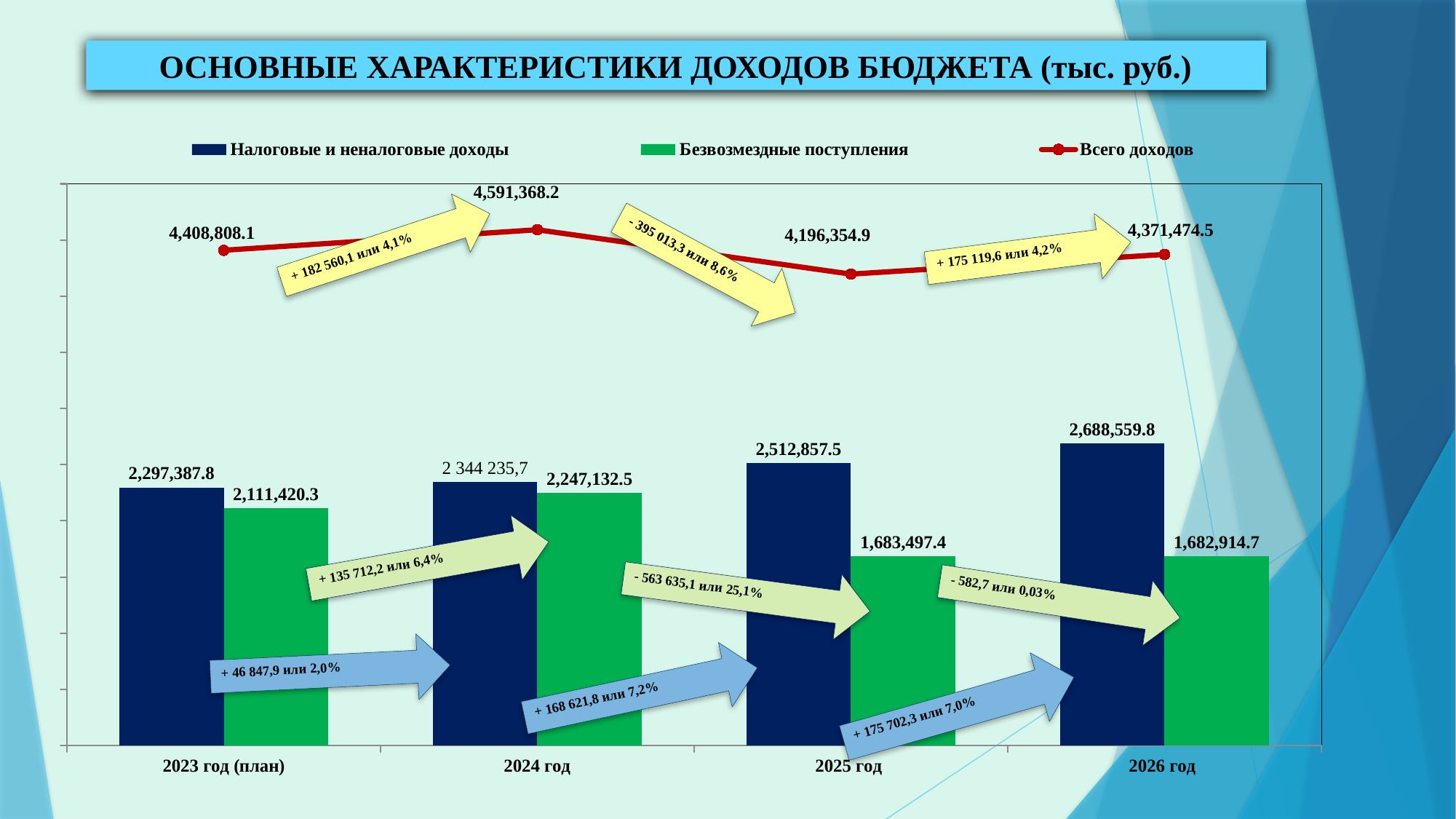
What is the value of Налоговые и неналоговые доходы for 2025 год? 2,512,857.5 Do the values of Налоговые и неналоговые доходы rise or fall from 2023 год (план) to 2026 год? rise In which year is Всего доходов the highest? 2024 год What is the value of Безвозмездные поступления for 2026 год? 1,682,914.7 In which year is Налоговые и неналоговые доходы the highest? 2026 год What is the value of Всего доходов for 2024 год? 4,591,368.2 What is the value of Безвозмездные поступления for 2023 год (план)? 2,111,420.3 In which year is Всего доходов the lowest? 2025 год What is the difference between Налоговые и неналоговые доходы and Безвозмездные поступления in 2025 год? 829,360.1 Which is larger in 2024 год: Налоговые и неналоговые доходы or Безвозмездные поступления? Налоговые и неналоговые доходы How many years are shown on the x axis? 4 How many series does the legend list? 3